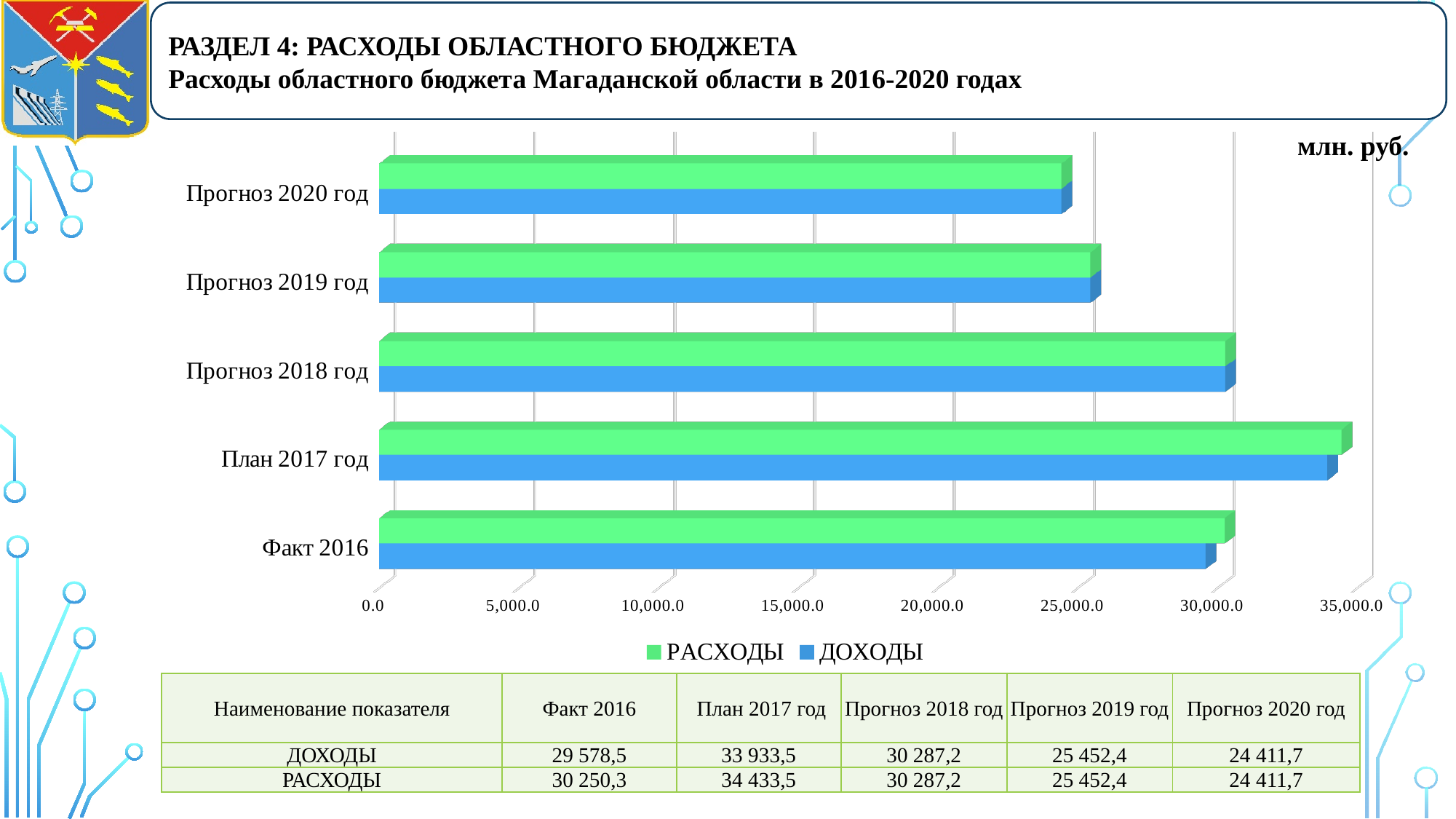
What is the value of РАСХОДЫ for План 2017 год? 34 433,5 How many categories (years) are shown on the chart? 5 Which category has the lowest value of ДОХОДЫ? Прогноз 2020 год Which category has the highest value of РАСХОДЫ? План 2017 год What is the value of ДОХОДЫ for Факт 2016? 29 578,5 How many series does the chart legend list? 2 What type of chart is shown on the slide? bar chart Is the value of ДОХОДЫ for Прогноз 2020 год greater or less than 25,000.0? less What is the difference between РАСХОДЫ and ДОХОДЫ for Факт 2016? 671,8 Which is larger for План 2017 год: РАСХОДЫ or ДОХОДЫ? РАСХОДЫ Which colour represents the РАСХОДЫ series in the chart? green What is the value of ДОХОДЫ for Прогноз 2020 год? 24 411,7